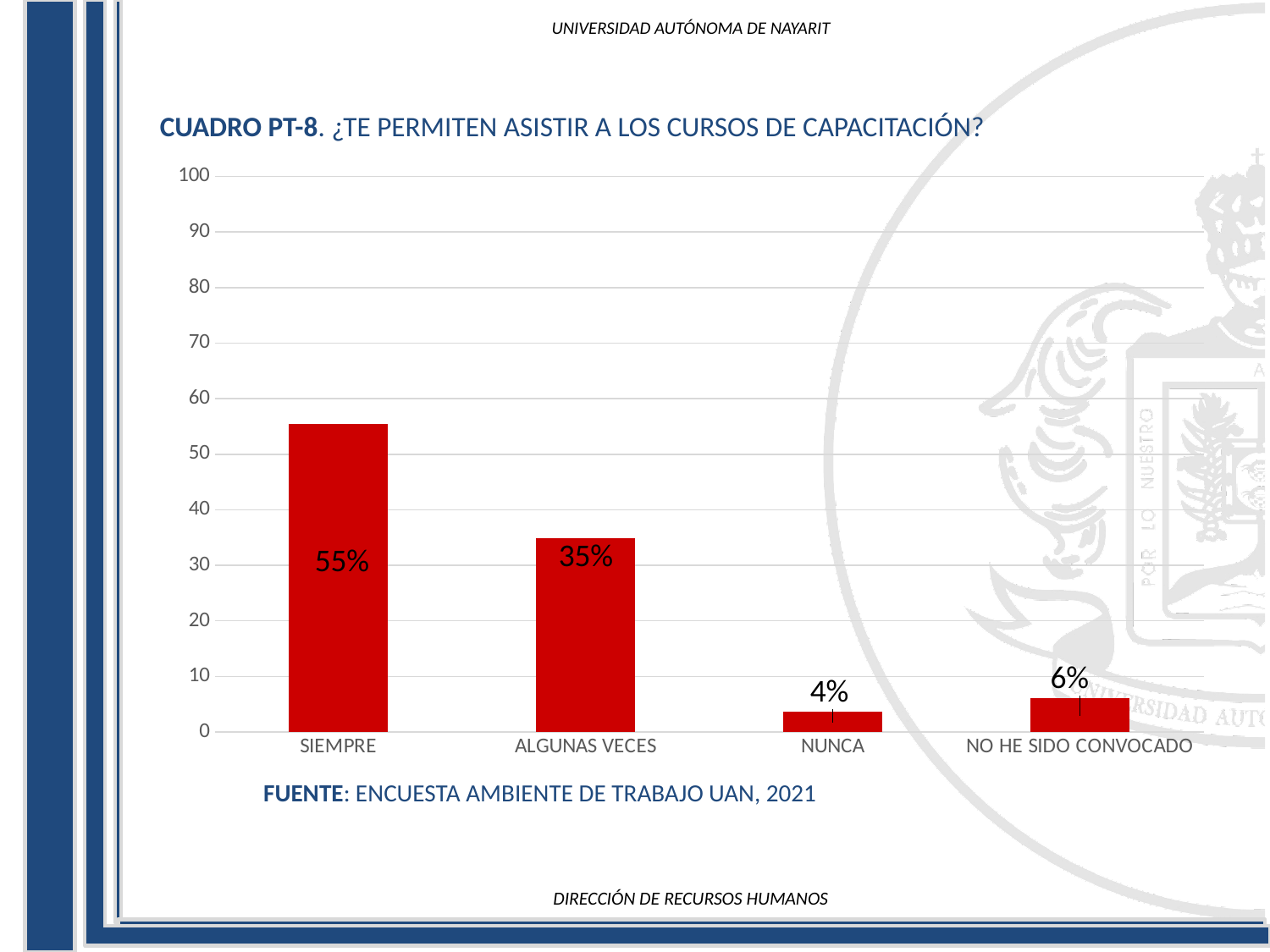
What is the value for NO HE SIDO CONVOCADO? 6% What is the value for NUNCA? 4% What is the difference between the values for SIEMPRE and ALGUNAS VECES? 20% How many categories are shown on the x axis? 4 Which category has the highest value? SIEMPRE What kind of chart is shown on the slide? bar chart Is the value for SIEMPRE greater or less than 50? greater What is the value for SIEMPRE? 55% What is the value for ALGUNAS VECES? 35% Which is larger, the value for NUNCA or the value for NO HE SIDO CONVOCADO? NO HE SIDO CONVOCADO Which category has the lowest value? NUNCA What is the source cited below the chart? ENCUESTA AMBIENTE DE TRABAJO UAN, 2021